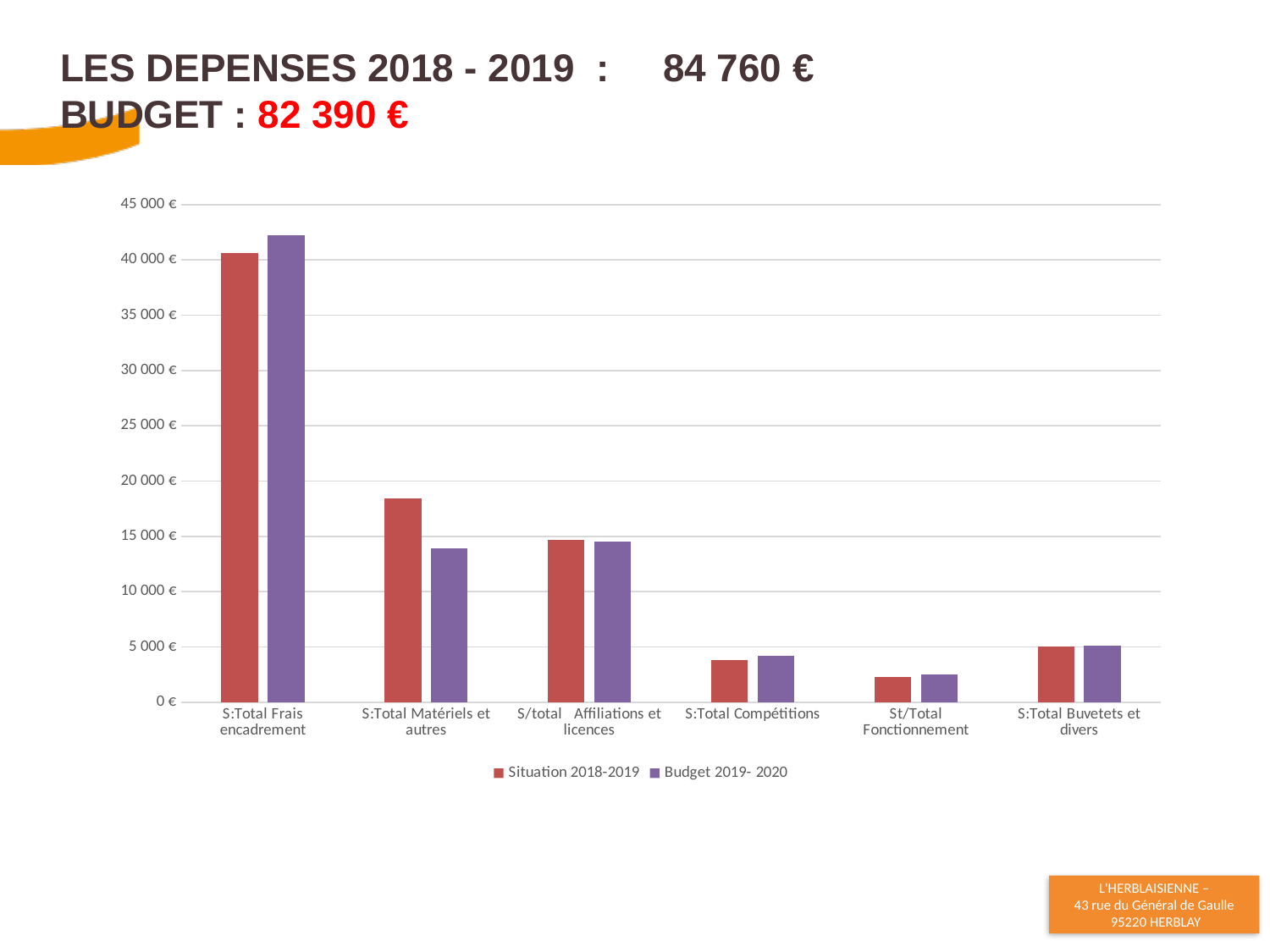
What colour are the bars for the Situation 2018-2019 series? red Is the Situation 2018-2019 value for S:Total Matériels et autres greater or less than 15 000 €? greater Is the Situation 2018-2019 value for S:Total Compétitions greater or less than 5 000 €? less For S:Total Matériels et autres, which is larger: Situation 2018-2019 or Budget 2019- 2020? Situation 2018-2019 Is the Budget 2019- 2020 value for S:Total Frais encadrement greater or less than 40 000 €? greater How many categories are shown on the x axis of the chart? 6 What kind of chart is shown on the slide? bar chart Which category has the lowest value for Budget 2019- 2020? St/Total Fonctionnement Which category has the highest value for Situation 2018-2019? S:Total Frais encadrement How many series does the chart legend list? 2 For S:Total Frais encadrement, which is larger: Situation 2018-2019 or Budget 2019- 2020? Budget 2019- 2020